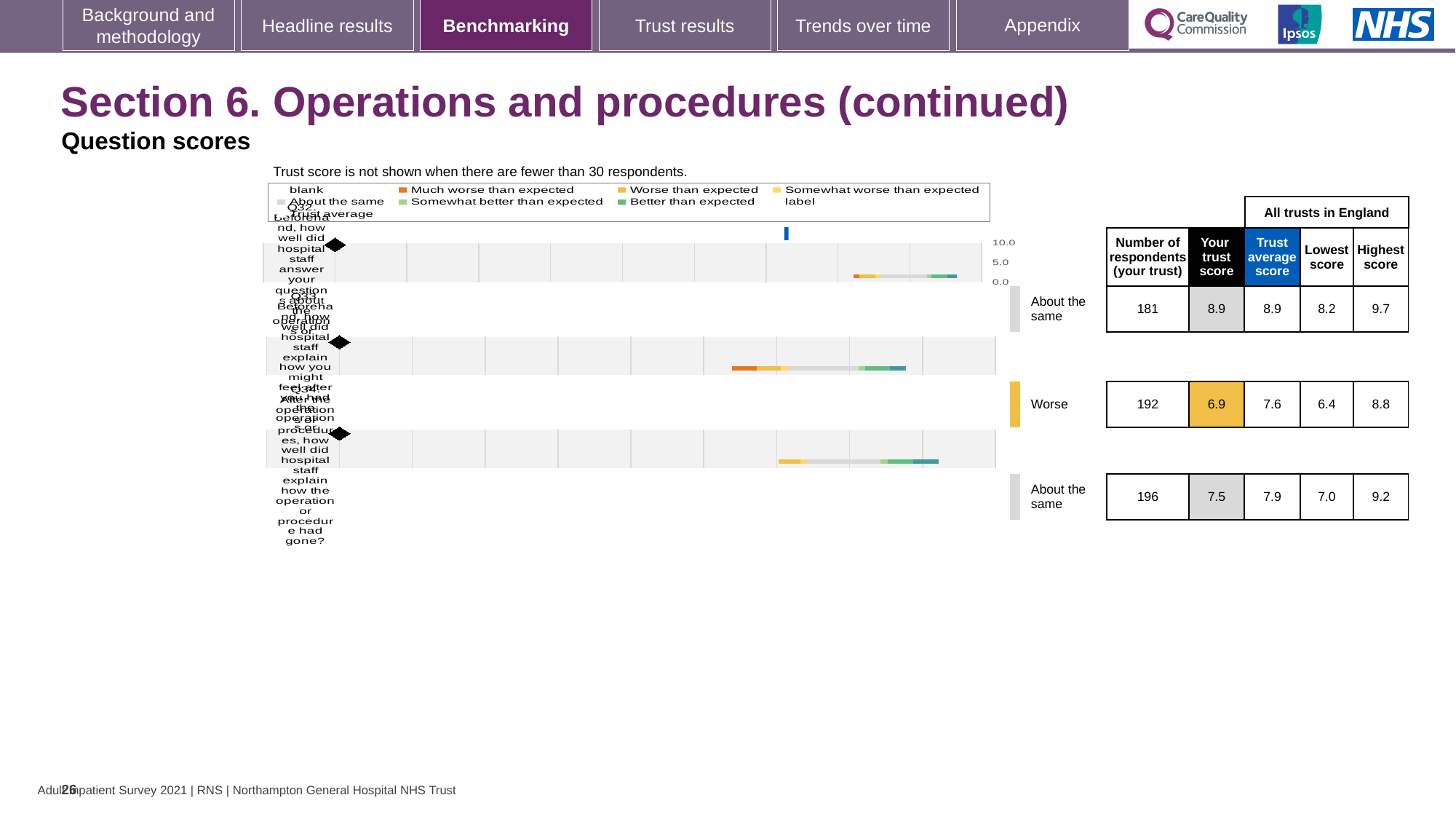
Is "Your trust score" larger for the first (top) row or the third (bottom) row? The first (top) row What is the "Lowest score" for the first (top) question row? 8.2 In the table beside the chart, how many respondents are shown for the row rated "Worse"? 192 Which question row has the highest number of respondents? The third (bottom) row, 196 For the row rated "Worse", how much higher is the trust average score than your trust score? 0.7 What kind of chart is shown? Bar chart What is "Your trust score" for the row rated "Worse"? 6.9 What is the "Highest score" for the third (bottom) question row? 9.2 What is the difference between the highest score and the lowest score for the first (top) row? 1.5 How many question rows are plotted on the chart? 3 What benchmark category label is shown next to the second question row? Worse What is the "Trust average score" for the row rated "Worse"? 7.6